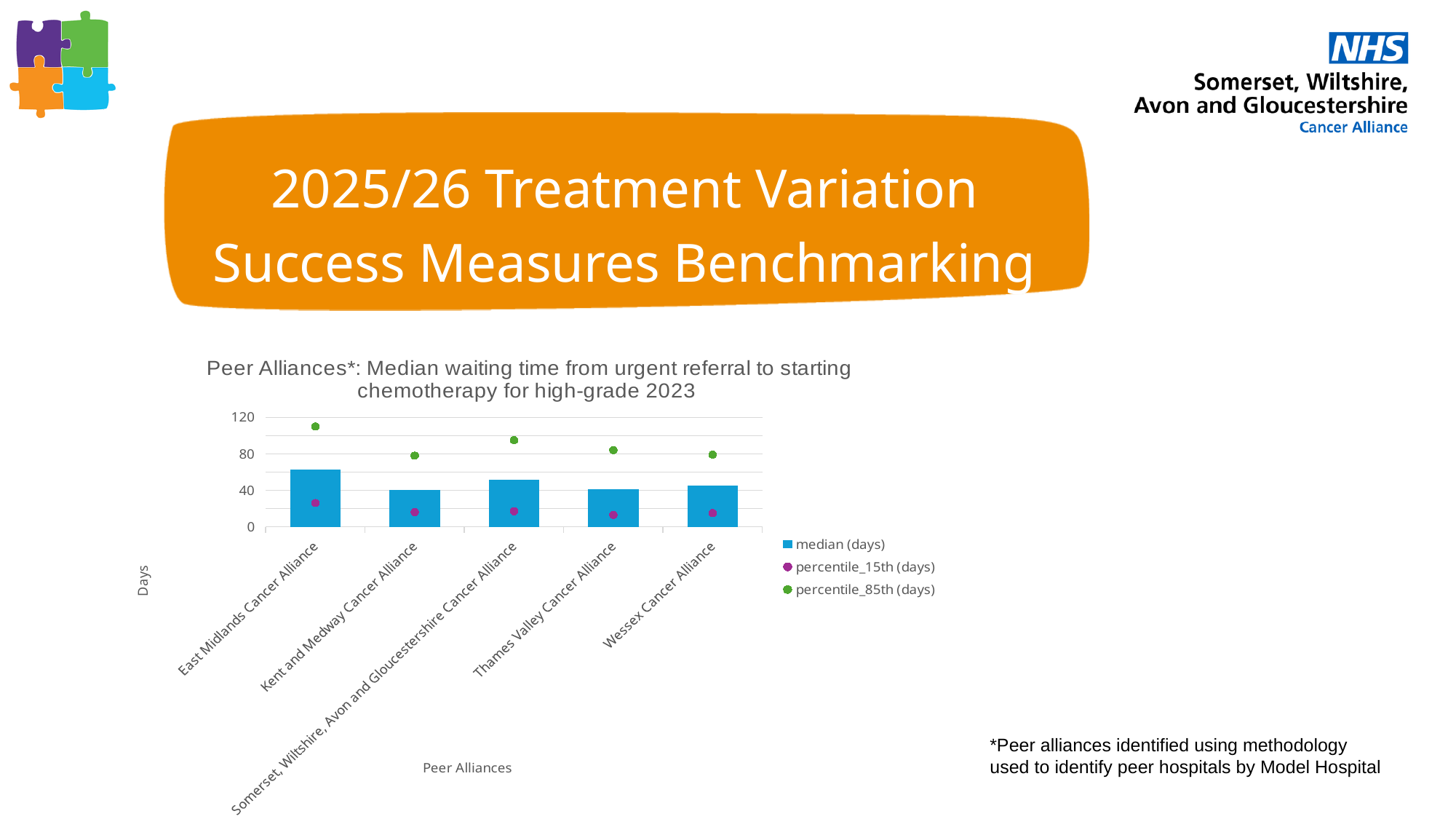
Which has the larger median (days) value: East Midlands Cancer Alliance or Kent and Medway Cancer Alliance? East Midlands Cancer Alliance Is the percentile_85th (days) value for East Midlands Cancer Alliance greater or less than 80? greater What kind of chart is shown on the slide? Bar chart Is the percentile_15th (days) value for Thames Valley Cancer Alliance greater or less than 40? less How many peer alliances are shown on the x axis of the chart? 5 What is the label on the chart's vertical axis? Days Is the median (days) value for Somerset, Wiltshire, Avon and Gloucestershire Cancer Alliance greater or less than 40? greater Which peer alliance has the highest percentile_85th (days) value? East Midlands Cancer Alliance Which has the larger percentile_85th (days) value: Somerset, Wiltshire, Avon and Gloucestershire Cancer Alliance or Kent and Medway Cancer Alliance? Somerset, Wiltshire, Avon and Gloucestershire Cancer Alliance How many series does the chart's legend list? 3 Which peer alliance has the highest median (days) bar? East Midlands Cancer Alliance